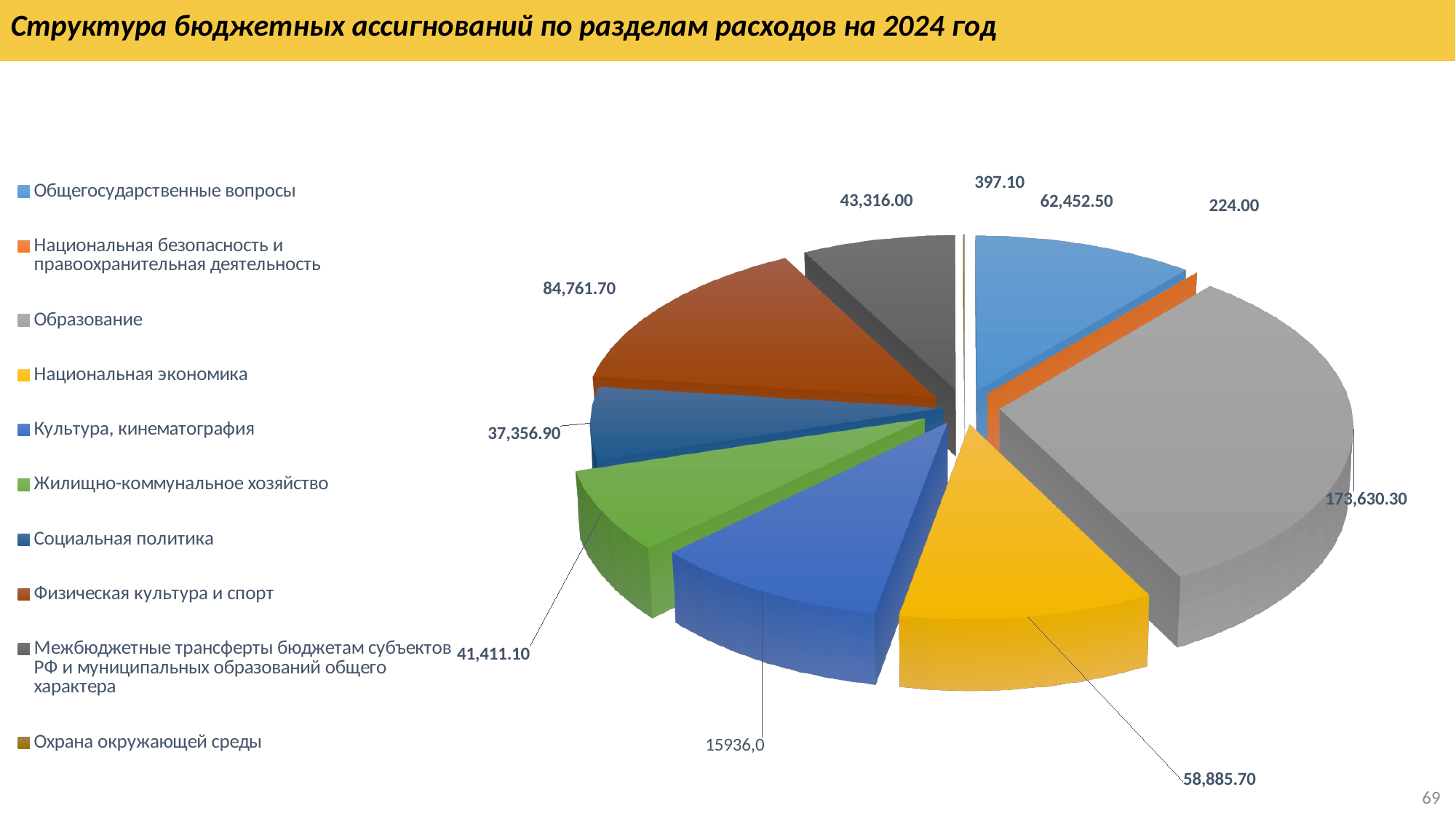
What is the value for Межбюджетные трансферты бюджетам субъектов РФ и муниципальных образований общего характера? 43,316.00 What is the value for Физическая культура и спорт? 84,761.70 What kind of chart is shown on the slide? Pie chart What is the difference between the values for Образование and Общегосударственные вопросы? 111,177.80 What is the value for Образование? 173,630.30 How many categories does the legend of the pie chart list? 10 What is the value for Социальная политика? 37,356.90 Which category has the smallest value in the pie chart? Национальная безопасность и правоохранительная деятельность What is the title of the slide's chart? Структура бюджетных ассигнований по разделам расходов на 2024 год What is the value for Общегосударственные вопросы? 62,452.50 Which category has the largest value in the pie chart? Образование Which is larger: Физическая культура и спорт or Национальная экономика? Физическая культура и спорт